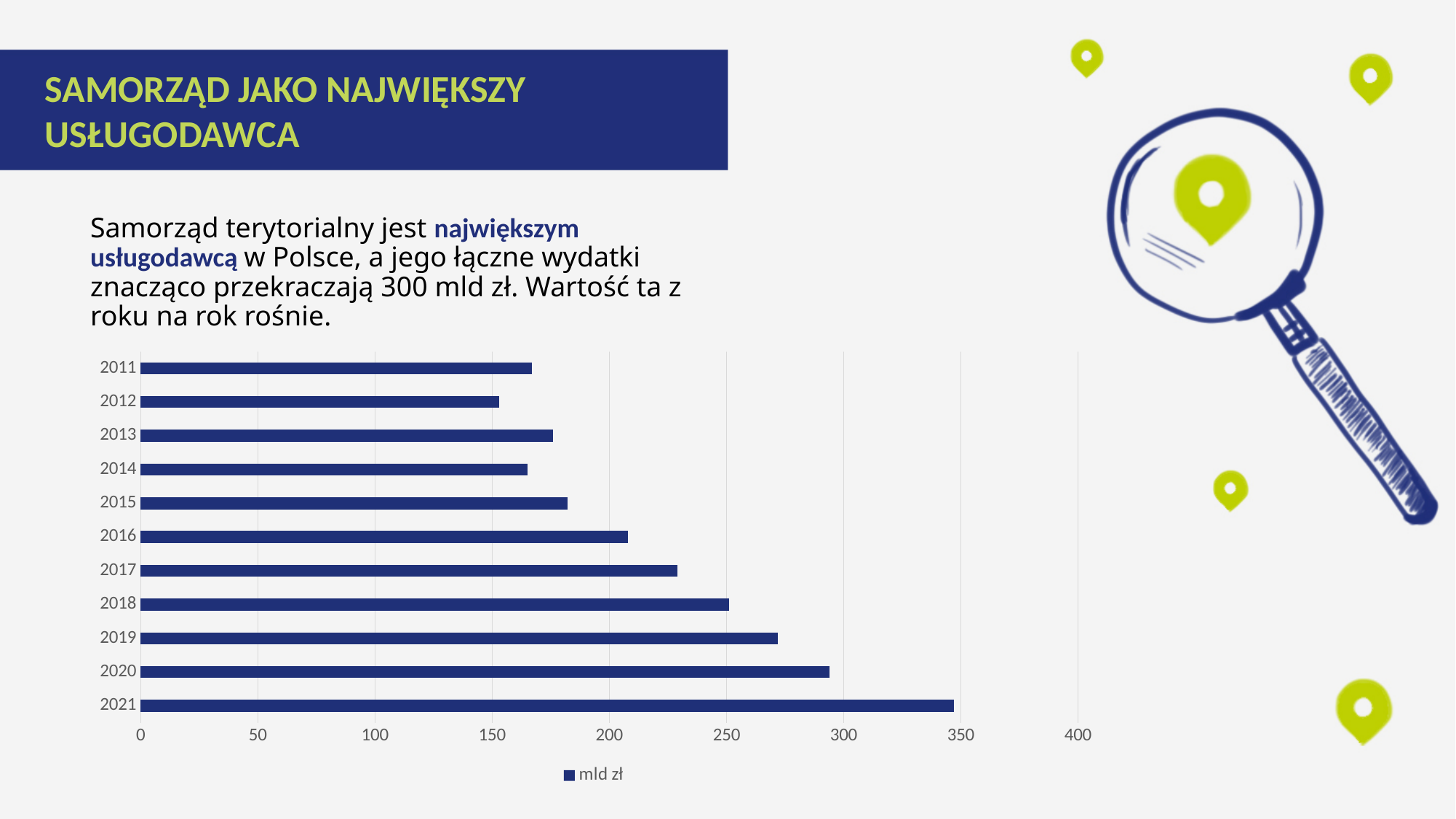
How many years are shown on the chart? 11 Is the value for 2012 greater or less than 200? less How many series does the legend list? 1 Which is larger, the value for 2013 or the value for 2014? 2013 What kind of chart is shown on the slide? bar chart Which year has the lowest value on the chart? 2012 What is the legend entry of the chart? mld zł Is the value for 2019 greater or less than 250? greater Do the values generally rise or fall from 2011 to 2021? rise Is the value for 2015 greater or less than 200? less Which year has the highest value on the chart? 2021